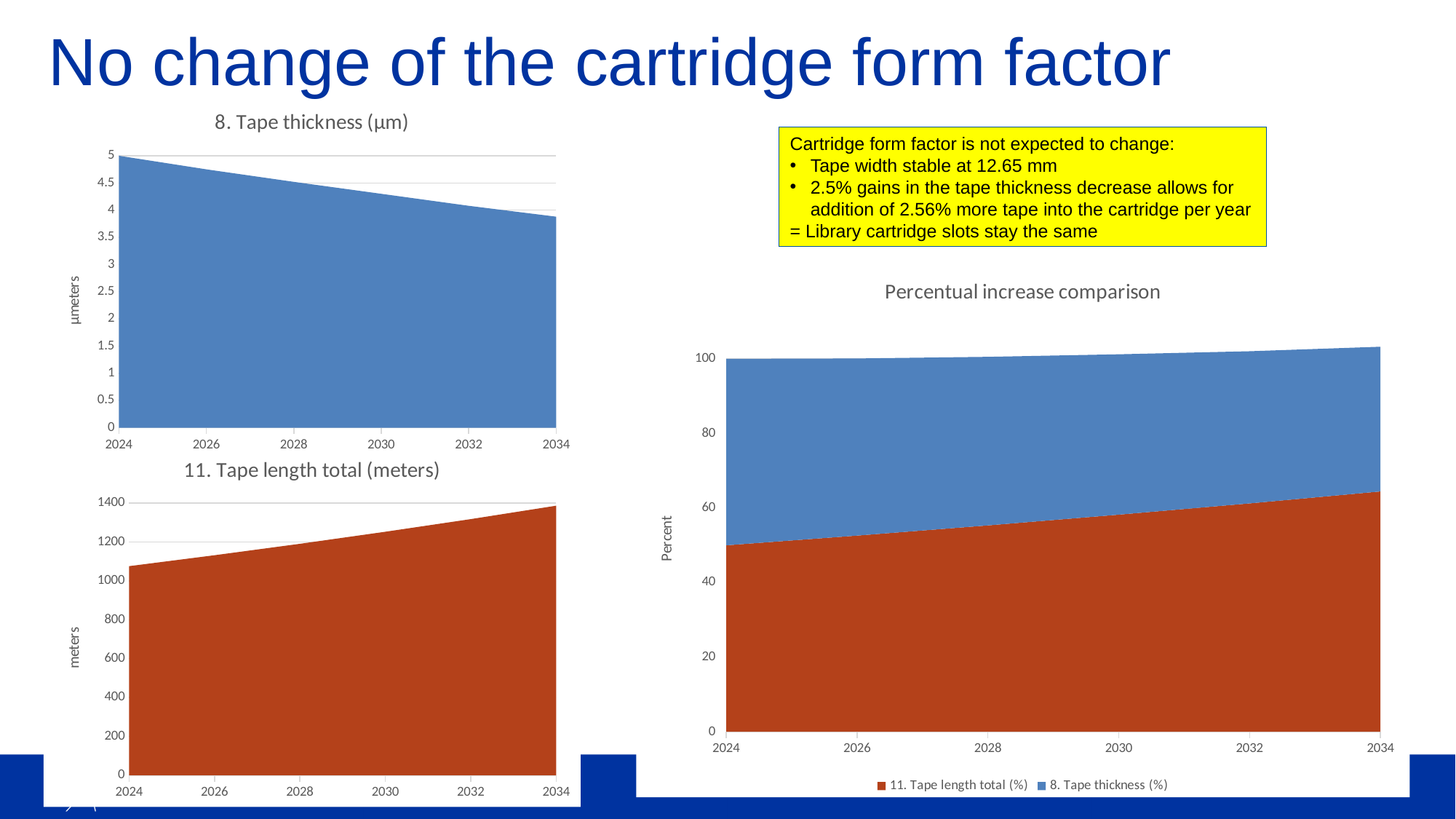
What is the y-axis label of the '11. Tape length total (meters)' chart? meters In the 'Percentual increase comparison' chart, is the value of '11. Tape length total (%)' for 2024 greater or less than 60? less In the 'Percentual increase comparison' chart, which series is shown in blue? 8. Tape thickness (%) In the '8. Tape thickness (µm)' chart, is the value for 2024 greater or less than 4.5? greater What kind of chart is the '8. Tape thickness (µm)' chart? area chart In the 'Percentual increase comparison' chart, is the value of '11. Tape length total (%)' for 2034 greater or less than 60? greater In the '11. Tape length total (meters)' chart, do the values rise or fall from 2024 to 2034? rise In the '8. Tape thickness (µm)' chart, do the values rise or fall from 2024 to 2034? fall In the 'Percentual increase comparison' chart, how many series does the legend list? 2